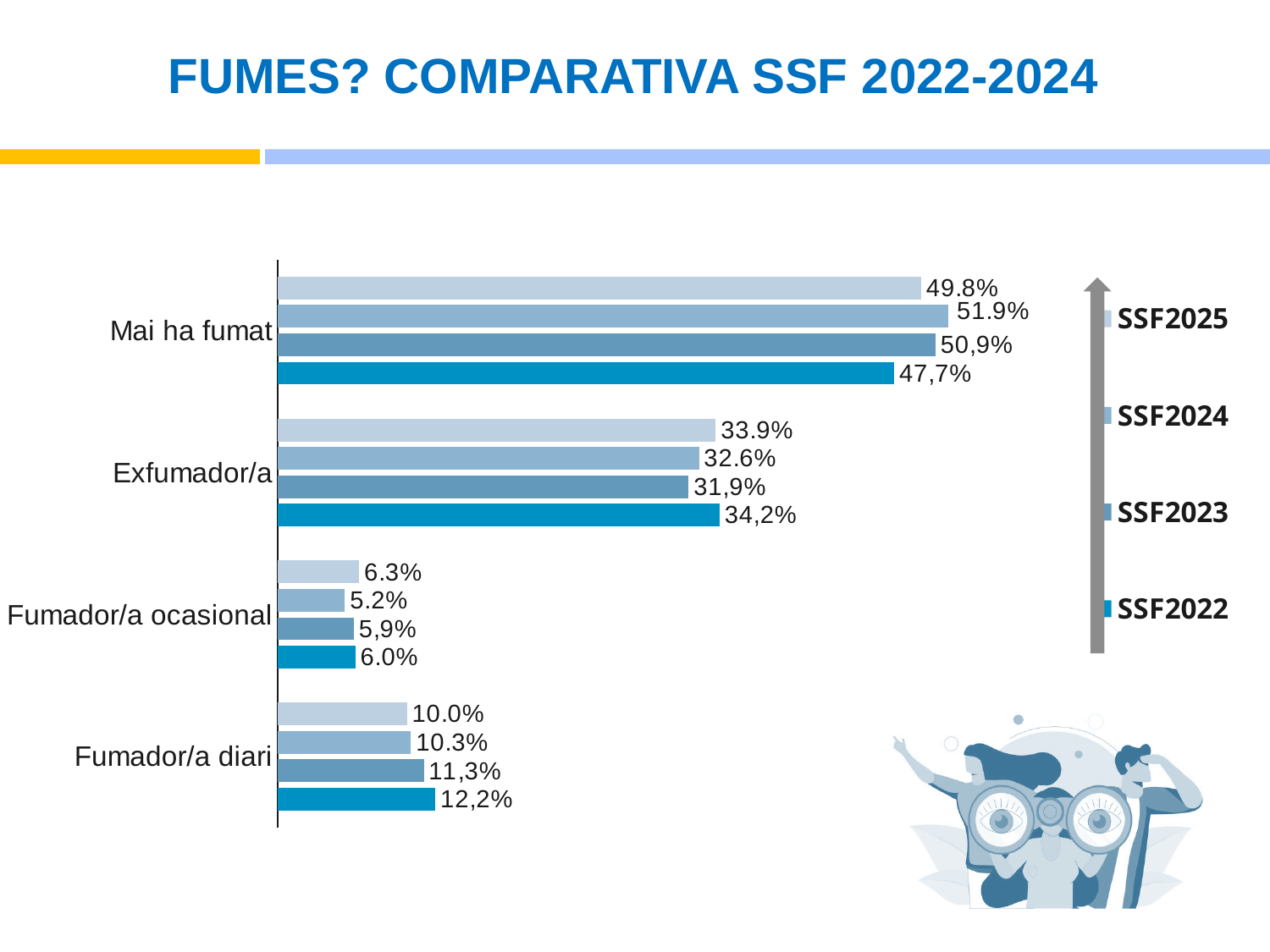
What is the value for Fumador/a ocasional in the SSF2023 series? 5,9% How many series does the legend list? 4 What is the value for Fumador/a diari in the SSF2022 series? 12,2% What kind of chart is shown on the slide? Bar chart Which is larger for Fumador/a diari: the SSF2022 value or the SSF2025 value? SSF2022 How many categories are shown on the chart? 4 Which series has the lowest value for Fumador/a ocasional? SSF2024 Does the value for Fumador/a diari rise or fall from SSF2022 to SSF2025? Fall What is the difference between the SSF2024 and SSF2025 values for Mai ha fumat? 2.1% What is the value for Mai ha fumat in the SSF2024 series? 51.9% What is the value for Exfumador/a in the SSF2025 series? 33.9% Which series has the highest value for Mai ha fumat? SSF2024